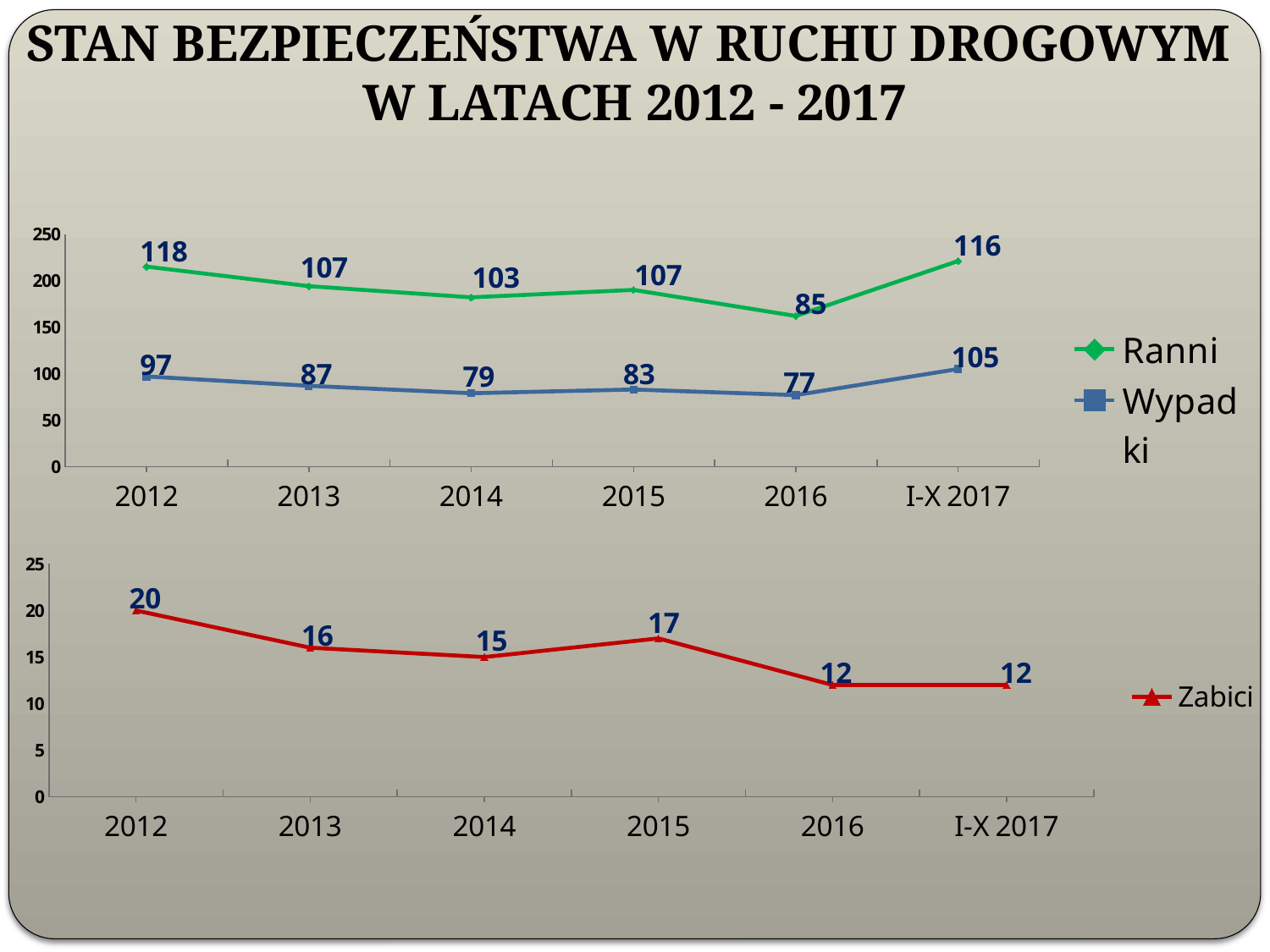
In the bottom chart, what is the difference between the Zabici values for 2012 and 2016? 8 In the top chart, what is the value for Ranni in 2012? 118 In the bottom chart, how many points are plotted for Zabici? 6 In the top chart, what is the value for Ranni in I-X 2017? 116 In the top chart, what is the difference between Ranni and Wypadki in 2016? 8 In the bottom chart, what is the value for Zabici in 2015? 17 In the top chart, which year has the lowest value for Wypadki? 2016 In the top chart, how many series does the legend list? 2 In the top chart, which year has the highest value for Ranni? 2012 What kind of chart is the bottom chart? line chart In the bottom chart, which year has the highest value for Zabici? 2012 In the top chart, what is the value for Wypadki in 2014? 79